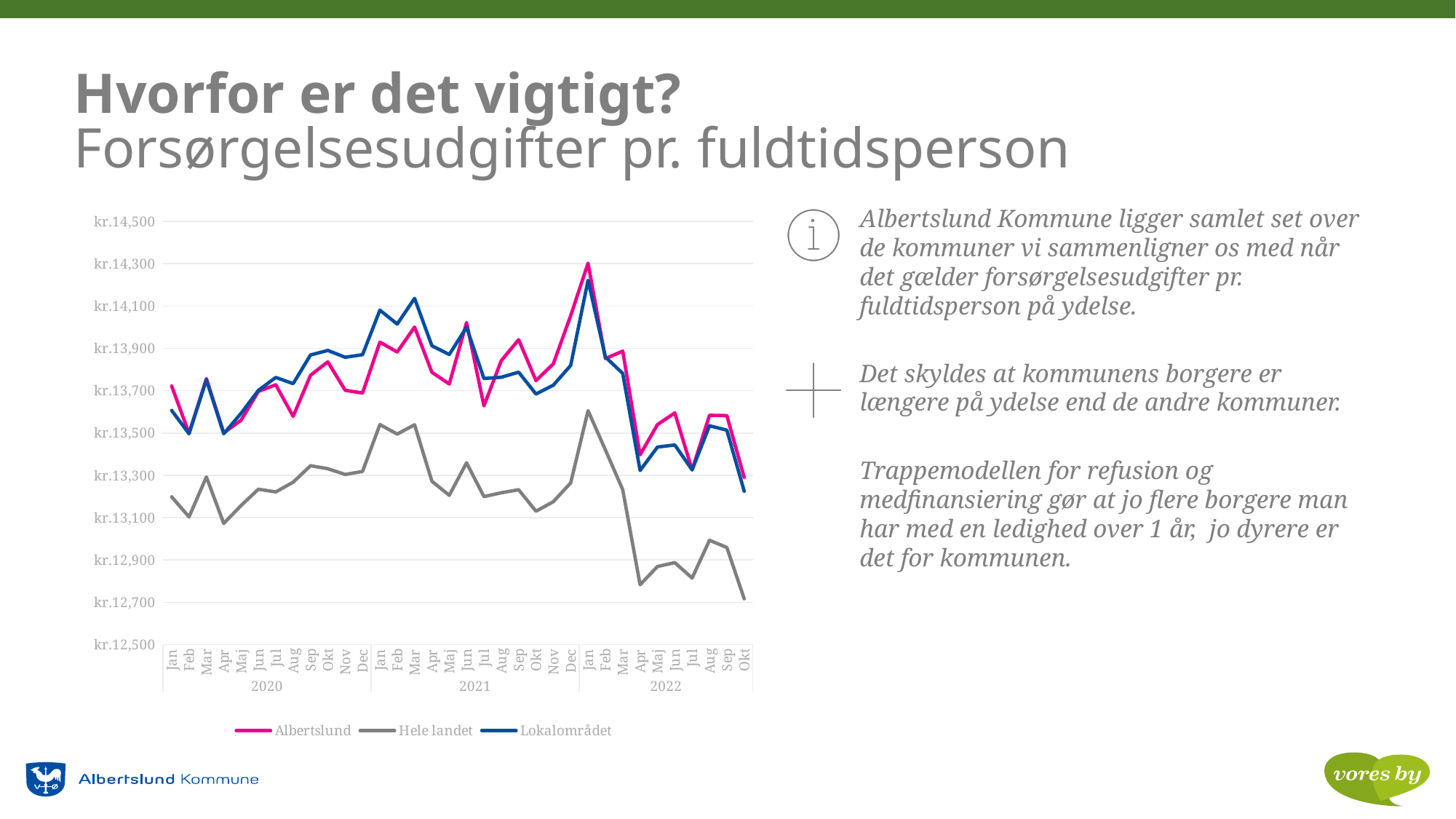
Is the value for Albertslund in Jan 2021 greater or less than kr.14,100? less How many years are shown on the x axis? 3 Does the Hele landet line rise or fall from Jan 2021 to Okt 2022? Fall How many series does the legend list? 3 Which series has the lowest values across the whole period? Hele landet Is the value for Hele landet in Okt 2022 greater or less than kr.12,900? less Which series is plotted with the grey line? Hele landet What kind of chart is shown on the slide? Line chart In which month is the Hele landet line at its lowest? Okt 2022 In which month is the Albertslund line at its highest? Jan 2022 Which series are listed in the legend? Albertslund, Hele landet, Lokalområdet Is the value for Albertslund in Okt 2022 greater or less than kr.13,500? less